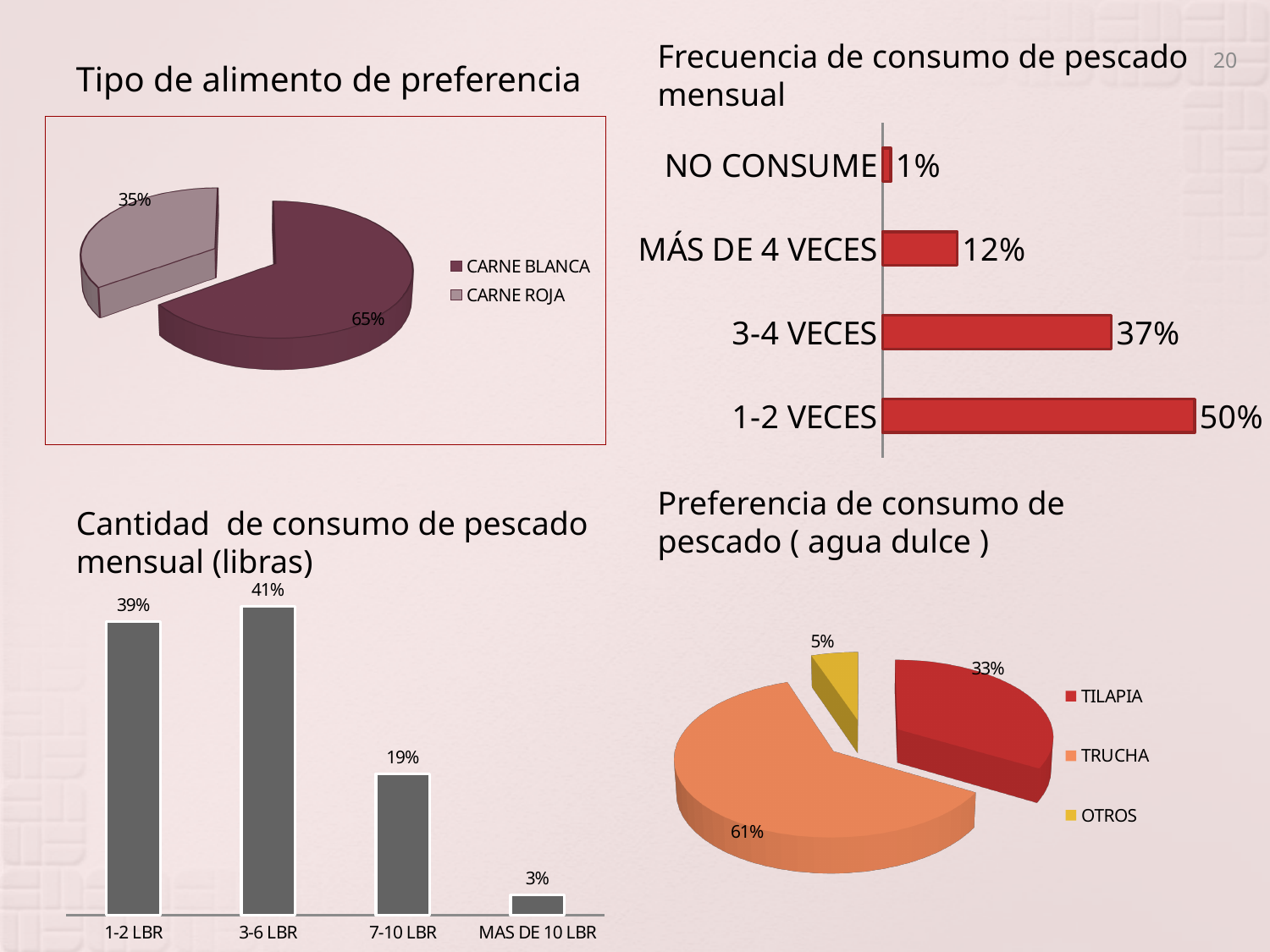
In the 'Cantidad de consumo de pescado mensual (libras)' chart, what is the value for 7-10 LBR? 19% In the 'Frecuencia de consumo de pescado mensual' chart, which category has the highest value? 1-2 VECES What kind of chart is 'Tipo de alimento de preferencia'? Pie chart In the 'Preferencia de consumo de pescado (agua dulce)' chart, what share is TRUCHA? 61% How many categories are shown in the 'Frecuencia de consumo de pescado mensual' chart? 4 In the 'Tipo de alimento de preferencia' chart, what share is CARNE BLANCA? 65% In the 'Cantidad de consumo de pescado mensual (libras)' chart, which is larger: 1-2 LBR or 3-6 LBR? 3-6 LBR In the 'Preferencia de consumo de pescado (agua dulce)' chart, what is the difference between TRUCHA and TILAPIA? 28% How many entries does the legend of the 'Preferencia de consumo de pescado (agua dulce)' chart list? 3 In the 'Cantidad de consumo de pescado mensual (libras)' chart, which category has the lowest value? MAS DE 10 LBR In the 'Frecuencia de consumo de pescado mensual' chart, what is the difference between 1-2 VECES and MÁS DE 4 VECES? 38% In the 'Frecuencia de consumo de pescado mensual' chart, what is the value for 3-4 VECES? 37%